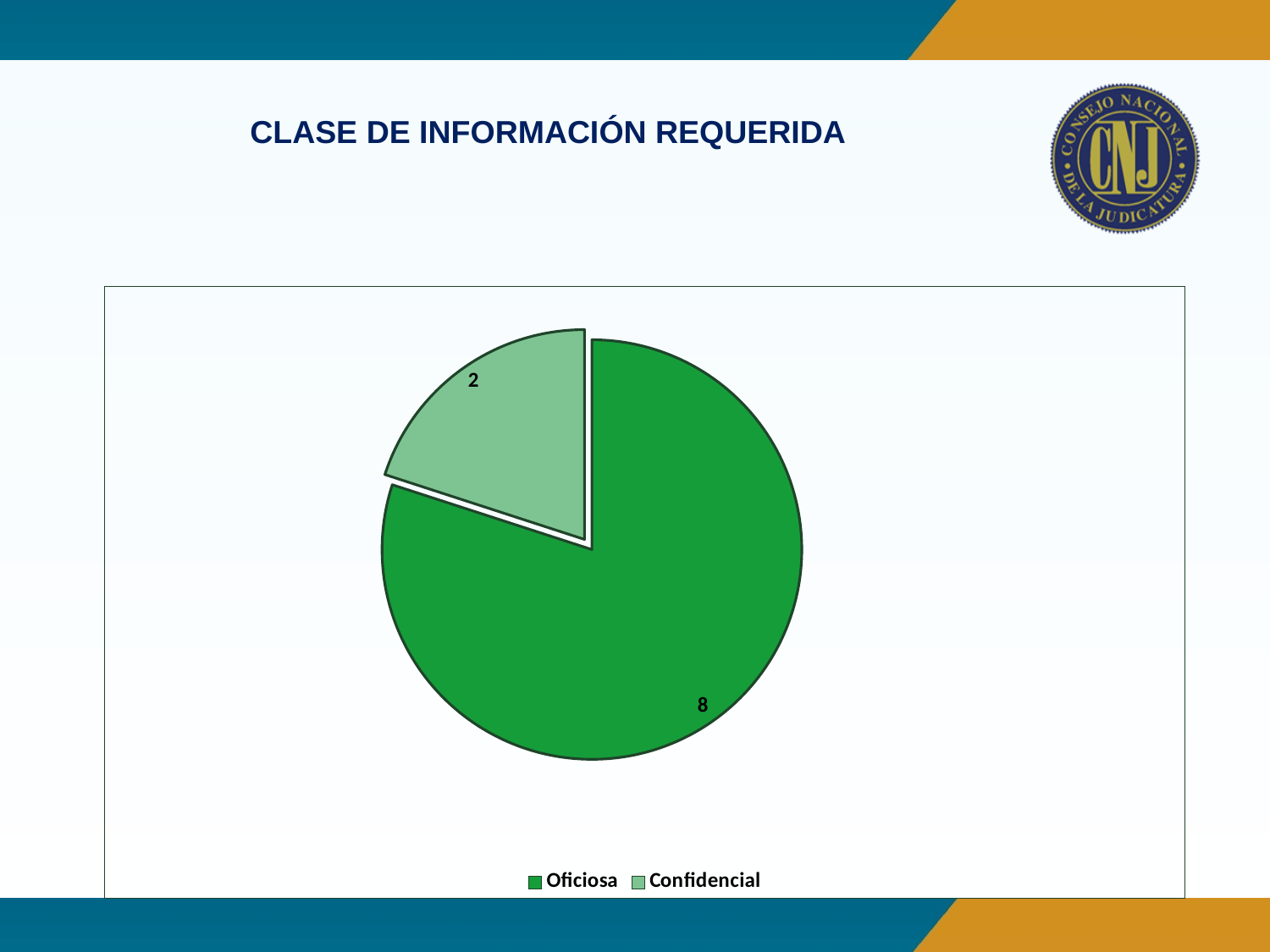
What is the title of the slide containing the chart? CLASE DE INFORMACIÓN REQUERIDA What type of chart is shown on the slide? pie chart What is the value for Confidencial? 2 How many entries does the legend list? 2 How many slices does the pie chart have? 2 What is the difference between the values for Oficiosa and Confidencial? 6 Which is larger, Oficiosa or Confidencial? Oficiosa What share of the pie does Confidencial represent? 20% Which category has the smallest slice? Confidencial What is the total of all slices in the pie chart? 10 What is the value for Oficiosa? 8 Which category has the largest slice? Oficiosa